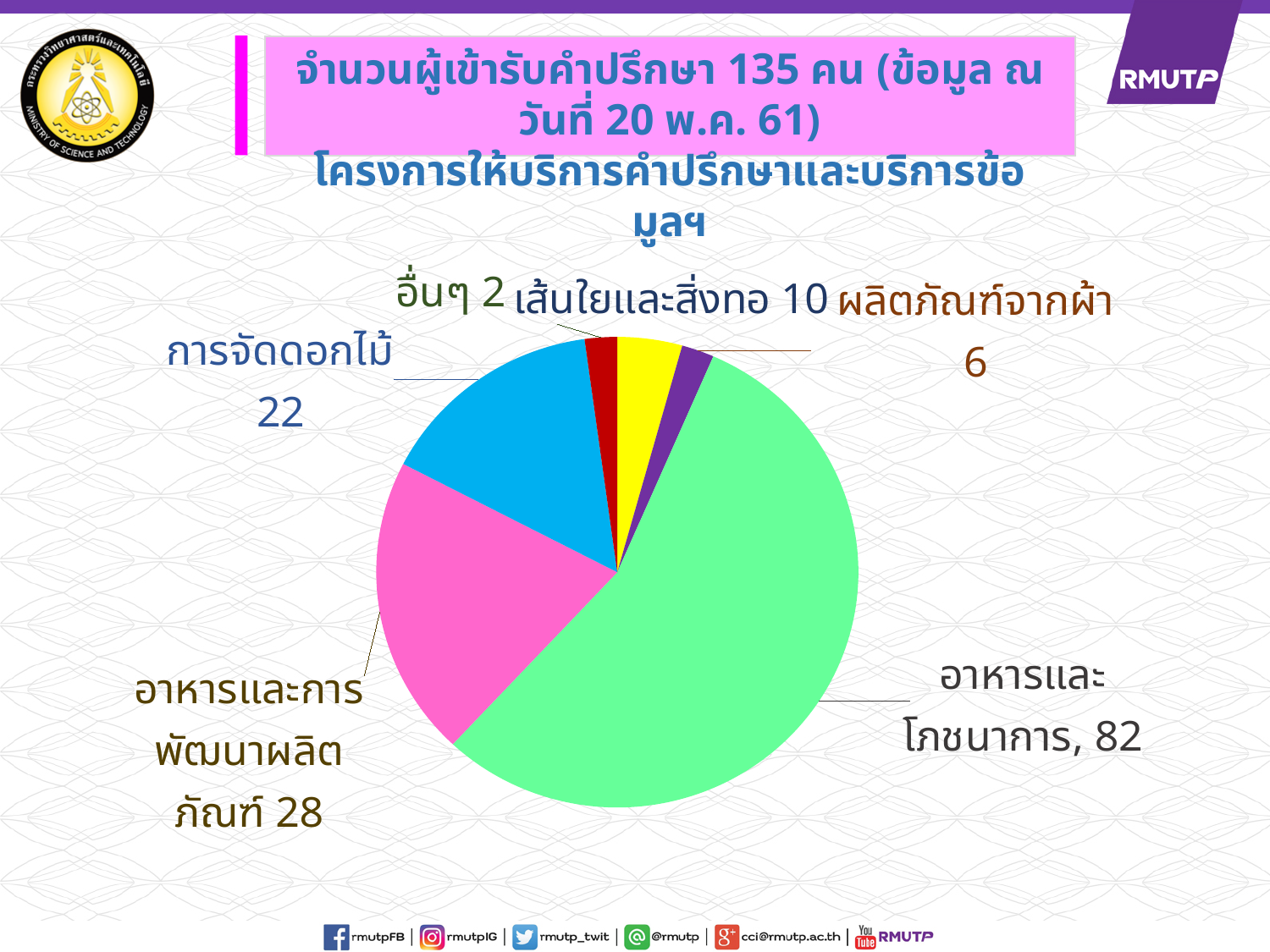
How many slices does the pie chart have? 6 What is the value for อาหารและโภชนาการ in the pie chart? 82 What is the value for อาหารและการพัฒนาผลิตภัณฑ์ in the pie chart? 28 What is the value for ผลิตภัณฑ์จากผ้า in the pie chart? 6 What is the value for การจัดดอกไม้ in the pie chart? 22 Which category has the largest slice in the pie chart? อาหารและโภชนาการ What colour is the slice for อาหารและโภชนาการ? green What is the difference between the values for อาหารและโภชนาการ and อาหารและการพัฒนาผลิตภัณฑ์? 54 What type of chart is shown on the slide? pie chart What is the value for เส้นใยและสิ่งทอ in the pie chart? 10 Which is larger, the value for การจัดดอกไม้ or the value for เส้นใยและสิ่งทอ? การจัดดอกไม้